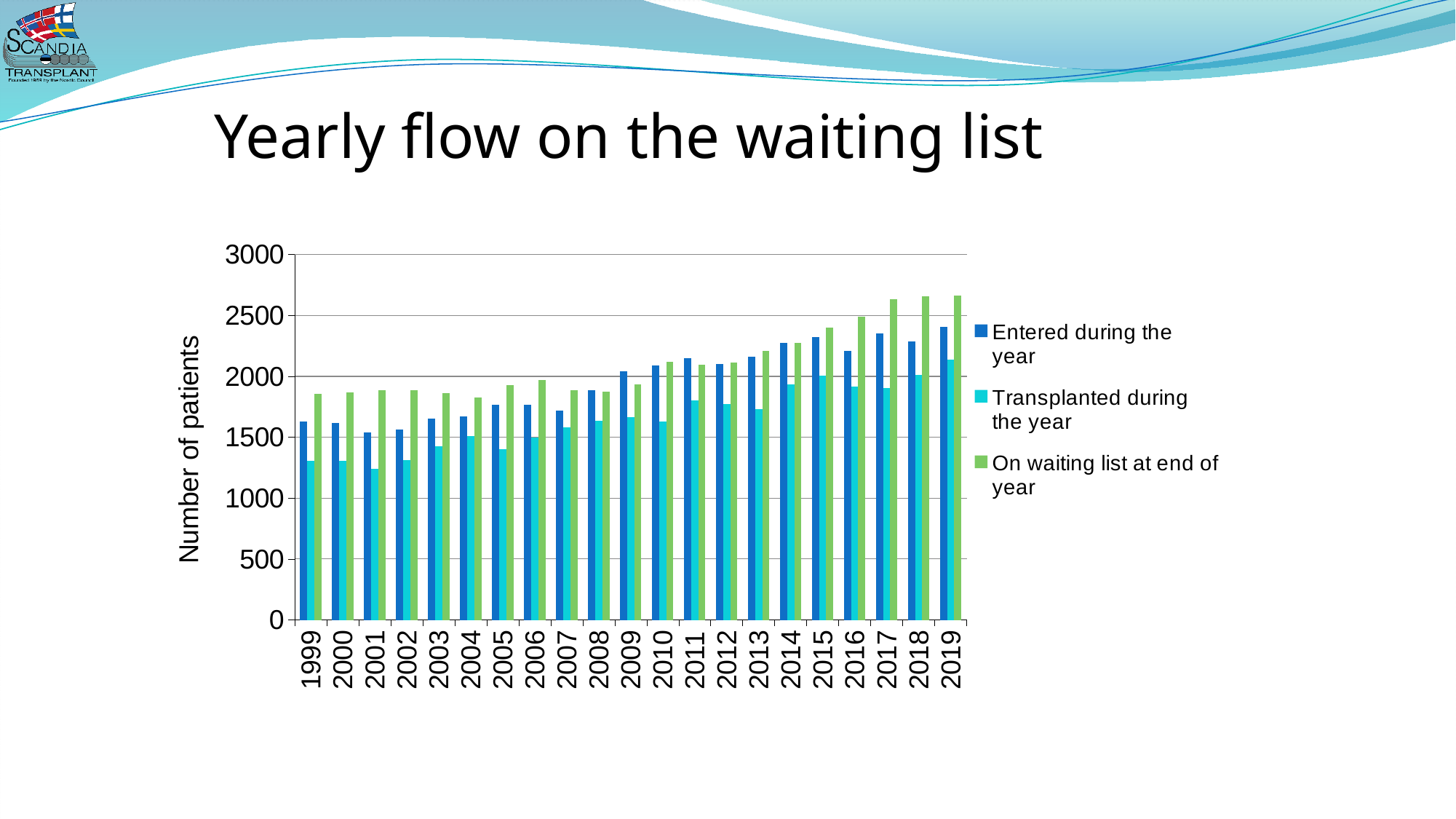
What is the label on the y axis? Number of patients In 1999, which is larger: 'Entered during the year' or 'On waiting list at end of year'? On waiting list at end of year Is the value for 'Transplanted during the year' in 1999 greater or less than 1500? less What kind of chart is shown on the slide? Bar chart Is the value for 'Transplanted during the year' in 2013 greater or less than 1500? greater How many years are shown on the x axis? 21 Is the value for 'Entered during the year' in 2019 greater or less than 2000? greater In which year is 'Transplanted during the year' highest? 2019 How many series does the legend list? 3 Does 'Transplanted during the year' generally rise or fall from 1999 to 2019? rise